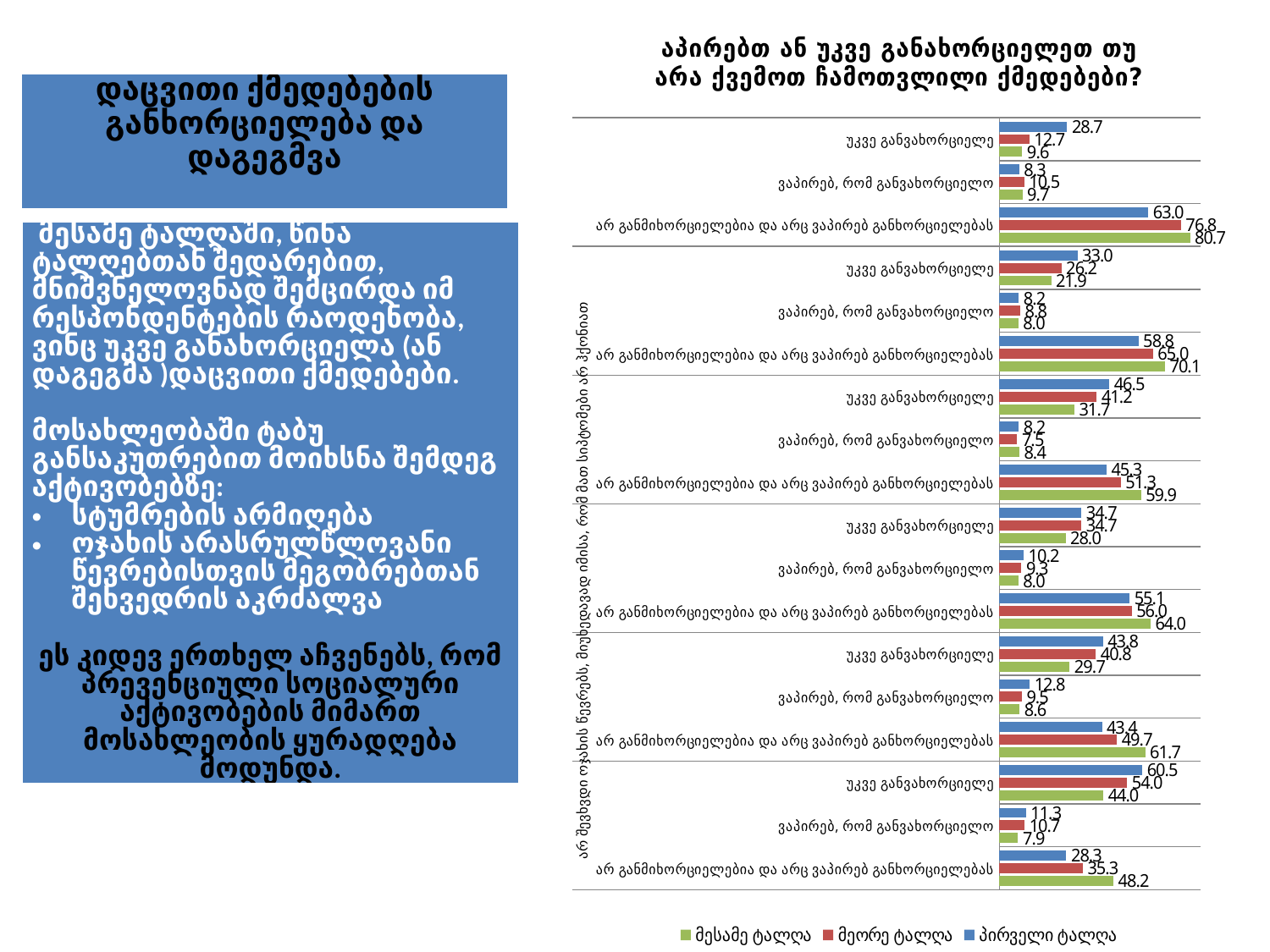
In the topmost group of the chart, what is the value of მესამე ტალღა for 'არ განმიხორციელებია და არც ვაპირებ განხორციელებას'? 80.7 Which series has the highest value in the entire chart, and what is that value? მესამე ტალღა, 80.7 How many series does the chart legend list? 3 In the bottom group, which is larger for 'უკვე განვახორციელე': პირველი ტალღა or მესამე ტალღა? პირველი ტალღა In the bottom group, what is the difference between the მესამე ტალღა and პირველი ტალღა values for 'არ განმიხორციელებია და არც ვაპირებ განხორციელებას'? 19.9 In the bottom group of the chart, what is the value of მეორე ტალღა for 'არ განმიხორციელებია და არც ვაპირებ განხორციელებას'? 35.3 In the topmost group, which is larger for 'არ განმიხორციელებია და არც ვაპირებ განხორციელებას': პირველი ტალღა or მეორე ტალღა? მეორე ტალღა Which colour represents მეორე ტალღა in the chart? red In the topmost group, what is the difference between the მეორე ტალღა and პირველი ტალღა values for 'უკვე განვახორციელე'? 16.0 What kind of chart is shown on the slide? bar chart In the topmost group of the chart, what is the value of პირველი ტალღა for 'უკვე განვახორციელე'? 28.7 In the bottom group of the chart, what is the value of პირველი ტალღა for 'უკვე განვახორციელე'? 60.5